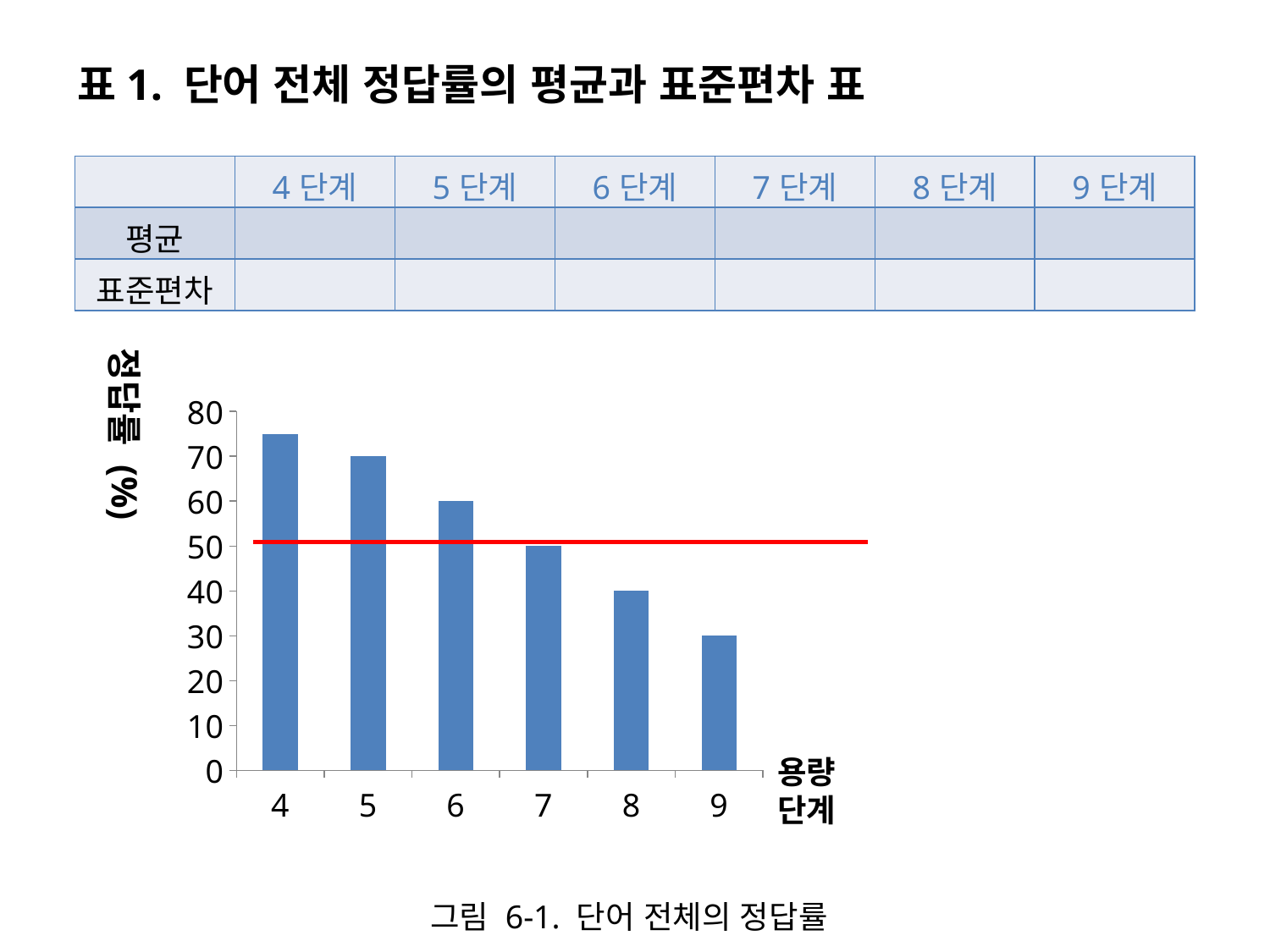
Which 용량 단계 has the highest 정답률? 4 What is the 정답률 (%) for 용량 단계 9? 30 What is the 정답률 (%) for 용량 단계 5? 70 What is the 정답률 (%) for 용량 단계 6? 60 Which 용량 단계 has the lowest 정답률? 9 What is the label on the vertical axis of the chart? 정답률 (%) Which has a higher 정답률, 용량 단계 5 or 용량 단계 8? 5 Is the 정답률 for 용량 단계 4 greater or less than 70? greater How many bars (용량 단계 categories) are plotted in the chart? 6 What is the 정답률 (%) for 용량 단계 8? 40 Do the 정답률 values rise or fall as the 용량 단계 increases from 4 to 9? fall What kind of chart is shown on the slide? bar chart